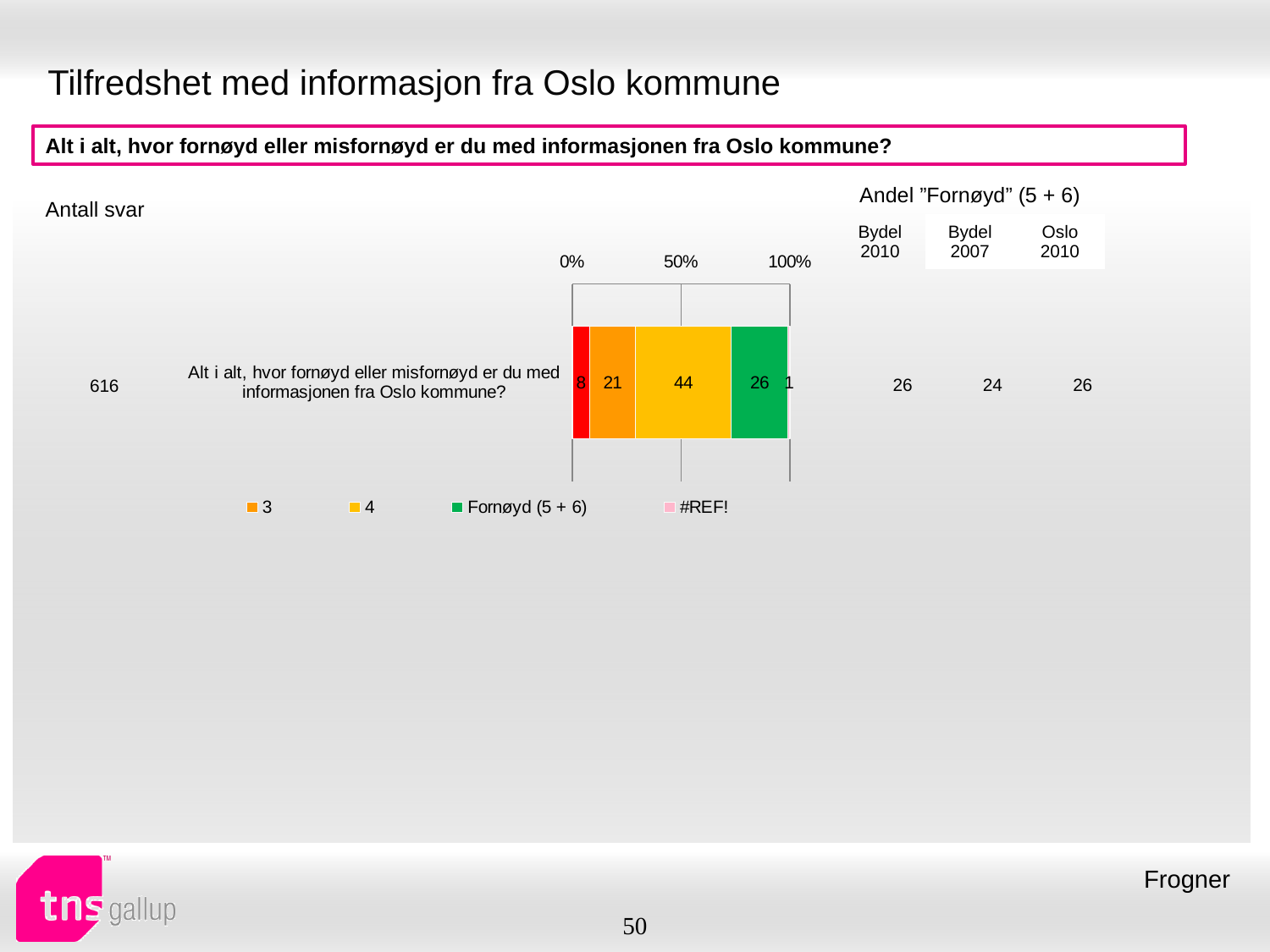
Which legend category has the largest segment in the stacked bar? 4 What is the 'Antall svar' (number of responses) shown next to the chart? 616 Which is larger: the segment for category 3 or the 'Fornøyd (5 + 6)' segment? Fornøyd (5 + 6) What is the smallest value labelled on the stacked bar? 1 What kind of chart is shown on the slide? Stacked bar chart What is the difference between the segment for category 4 and the 'Fornøyd (5 + 6)' segment? 18 How many entries does the chart legend list? 4 What is the value of the segment for category 3 in the stacked bar? 21 What is the value of the 'Fornøyd (5 + 6)' segment in the stacked bar? 26 What is the total of all labelled segments in the stacked bar? 100 What is the value of the segment for category 4 in the stacked bar? 44 How many bars does the chart contain? 1